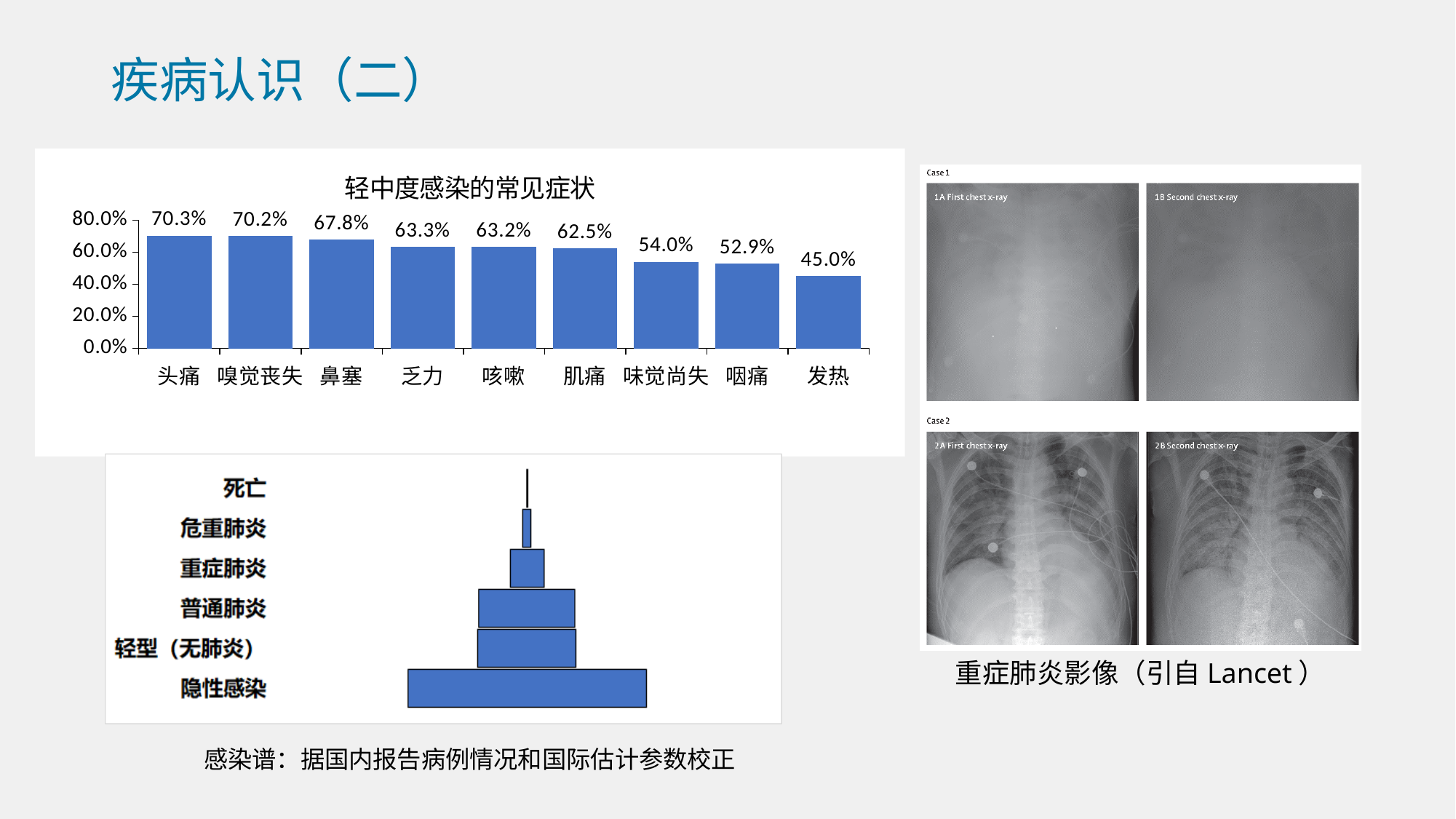
In the bar chart titled 轻中度感染的常见症状, which symptom has the lowest value? 发热 In the bar chart titled 轻中度感染的常见症状, which is larger, the value for 肌痛 or the value for 味觉尚失? 肌痛 In the bar chart titled 轻中度感染的常见症状, what is the difference between the values for 鼻塞 and 乏力? 4.5% In the bar chart titled 轻中度感染的常见症状, what is the difference between the values for 头痛 and 发热? 25.3% In the bar chart titled 轻中度感染的常见症状, what is the value for 发热? 45.0% What kind of chart is the chart titled 轻中度感染的常见症状? bar chart In the bar chart titled 轻中度感染的常见症状, what is the value for 咳嗽? 63.2% In the bar chart titled 轻中度感染的常见症状, what is the value for 头痛? 70.3% In the bar chart titled 轻中度感染的常见症状, which symptom has the highest value? 头痛 How many symptom categories are shown in the bar chart titled 轻中度感染的常见症状? 9 In the bar chart titled 轻中度感染的常见症状, is the value for 咽痛 greater or less than 60.0%? less In the bar chart titled 轻中度感染的常见症状, do the values rise or fall from left to right along the x axis? fall